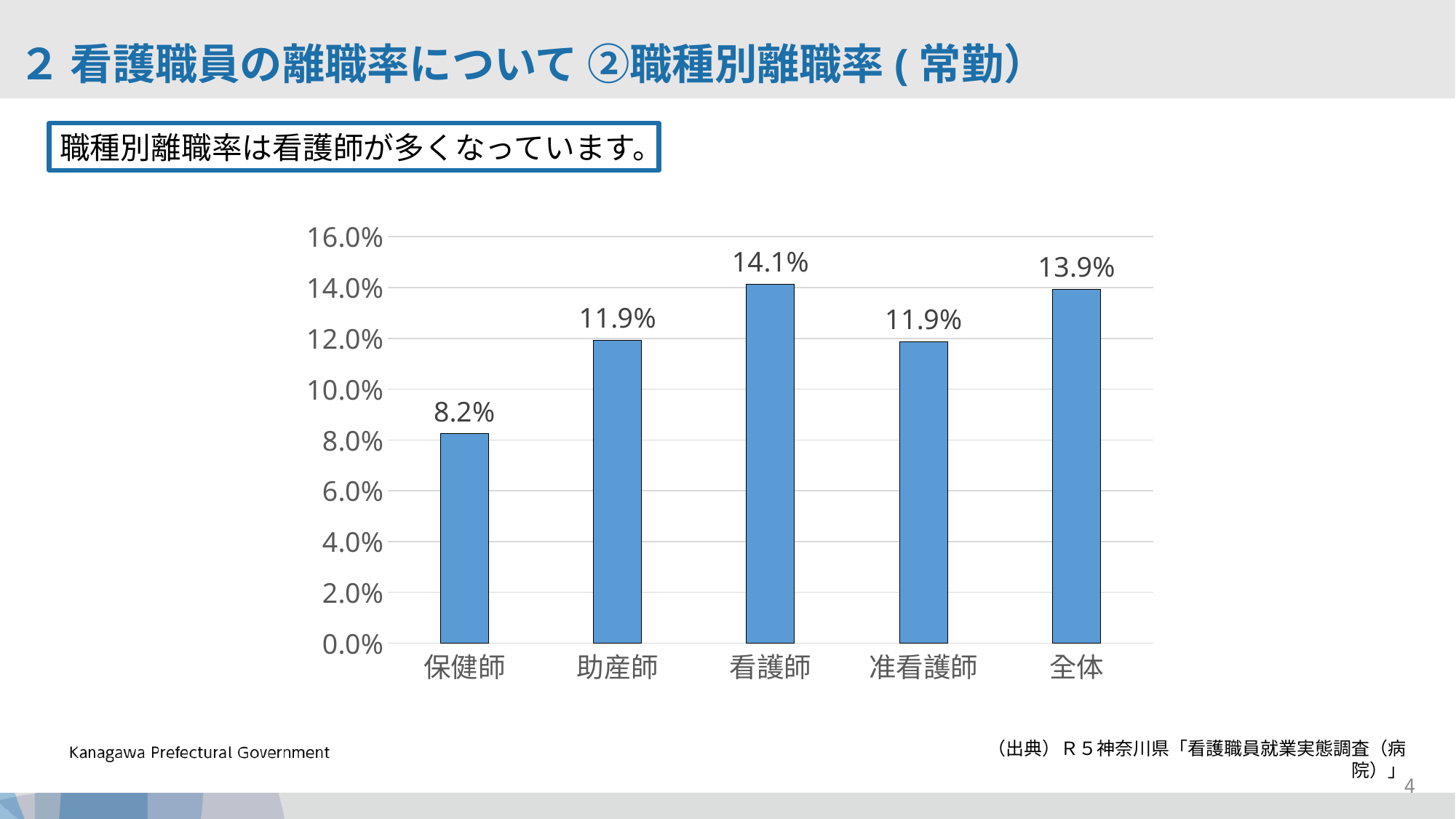
What is the difference between the turnover rates of 看護師 and 全体? 0.2% What is the turnover rate for 全体? 13.9% Is the value for 保健師 greater or less than 10.0%? less What is the turnover rate for 助産師? 11.9% What is the turnover rate for 保健師? 8.2% Which category has the lowest turnover rate? 保健師 How many categories are shown on the x axis? 5 What is the turnover rate for 看護師? 14.1% What is the difference between the turnover rates of 看護師 and 保健師? 5.9% What kind of chart is shown on the slide? bar chart Which has a higher turnover rate, 准看護師 or 全体? 全体 Which category has the highest turnover rate? 看護師